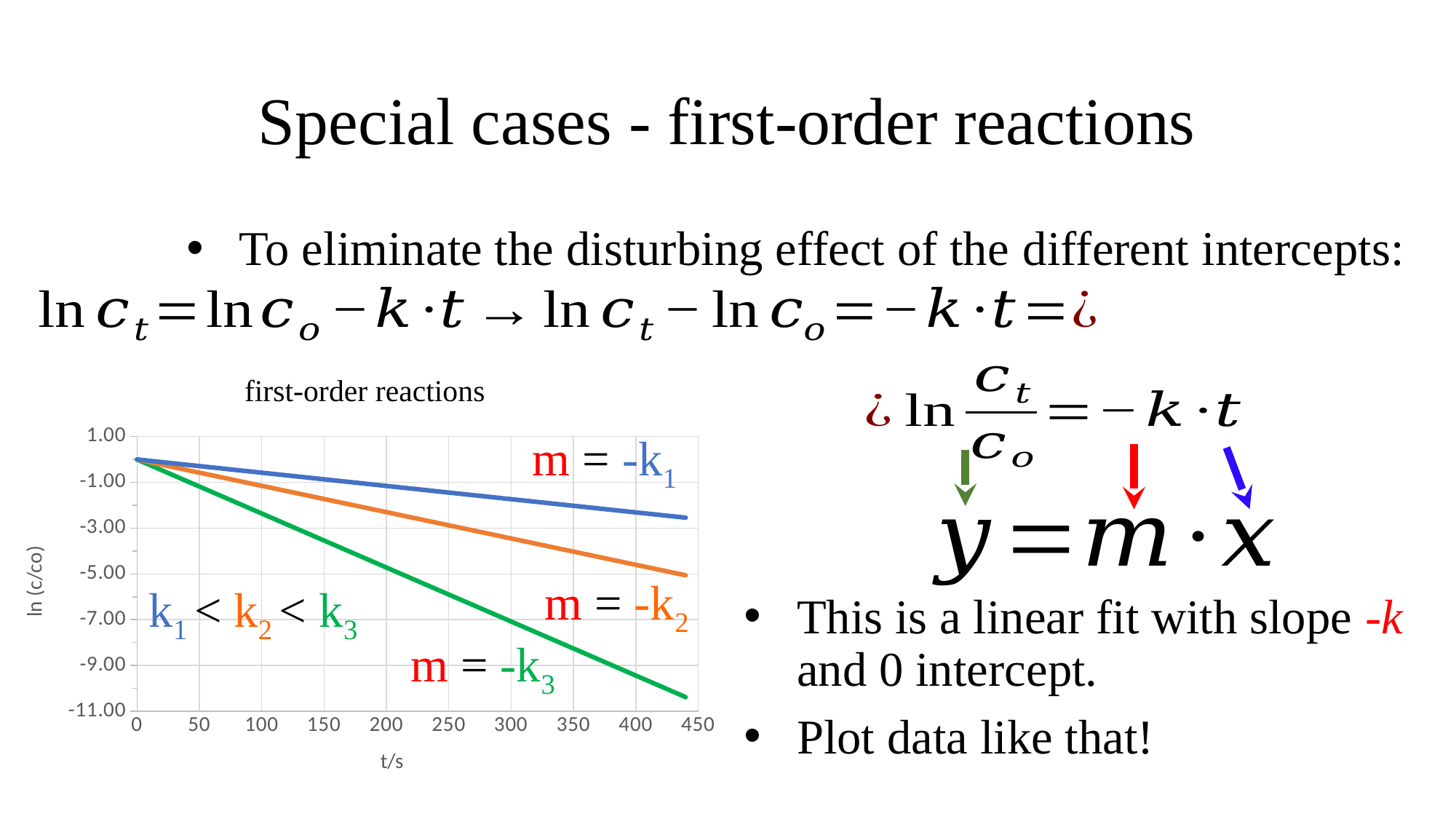
What is the label of the x axis of the chart? t/s At t/s = 200, is the value of the green line greater or less than -3.00? less At t/s = 300, which line has the larger value: the orange line or the green line? orange Which line is highest at t/s = 400: the blue, orange or green line? blue What kind of chart is shown on the slide? line chart At t/s = 400, is the value of the orange line greater or less than -3.00? less What is the title of the chart? first-order reactions At t/s = 400, is the value of the blue line greater or less than -3.00? greater Do the plotted lines rise or fall as t/s increases? fall How many lines are plotted in the chart? 3 Which line is lowest at t/s = 400: the blue, orange or green line? green